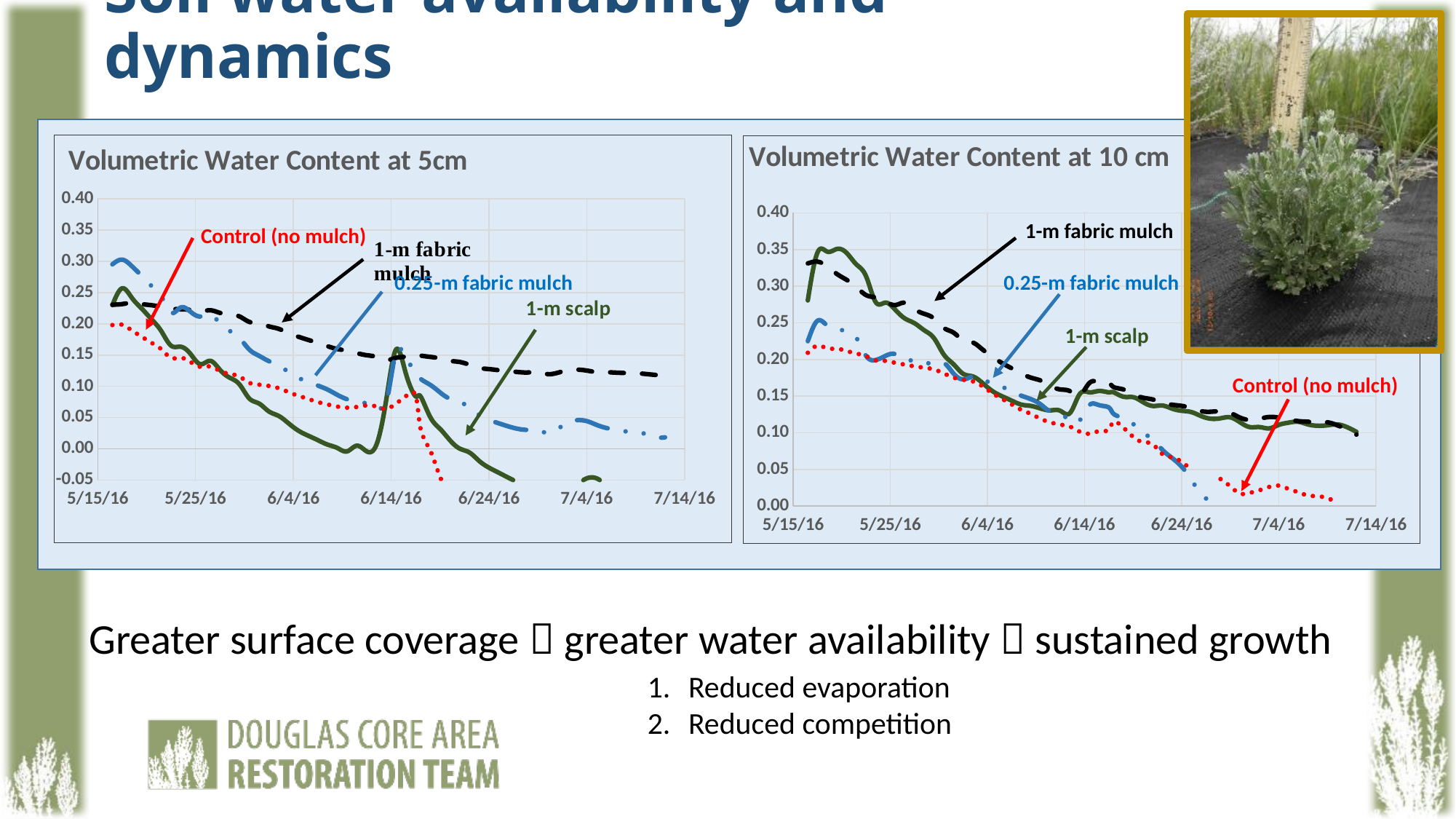
On the 'Volumetric Water Content at 10 cm' chart, which is larger at 7/4/16: 1-m fabric mulch or Control (no mulch)? 1-m fabric mulch On the 'Volumetric Water Content at 10 cm' chart, does the Control (no mulch) series generally rise or fall from 5/15/16 to 7/14/16? fall How many date labels are shown on the x axis of the 'Volumetric Water Content at 10 cm' chart? 7 How many series are labelled on the 'Volumetric Water Content at 10 cm' chart? 4 What kind of chart is the 'Volumetric Water Content at 5cm' chart? line chart On the 'Volumetric Water Content at 5cm' chart, is the value for 1-m fabric mulch at 7/4/16 greater or less than 0.10? greater On the 'Volumetric Water Content at 5cm' chart, which series is labelled with a red dotted line? Control (no mulch) On the 'Volumetric Water Content at 5cm' chart, which series has the highest value at 7/14/16? 1-m fabric mulch On the 'Volumetric Water Content at 5cm' chart, is the value for 0.25-m fabric mulch at 7/4/16 greater or less than 0.10? less On the 'Volumetric Water Content at 10 cm' chart, is the value for 1-m fabric mulch at 5/15/16 greater or less than 0.30? greater On the 'Volumetric Water Content at 5cm' chart, which is larger at 7/4/16: 1-m fabric mulch or 0.25-m fabric mulch? 1-m fabric mulch